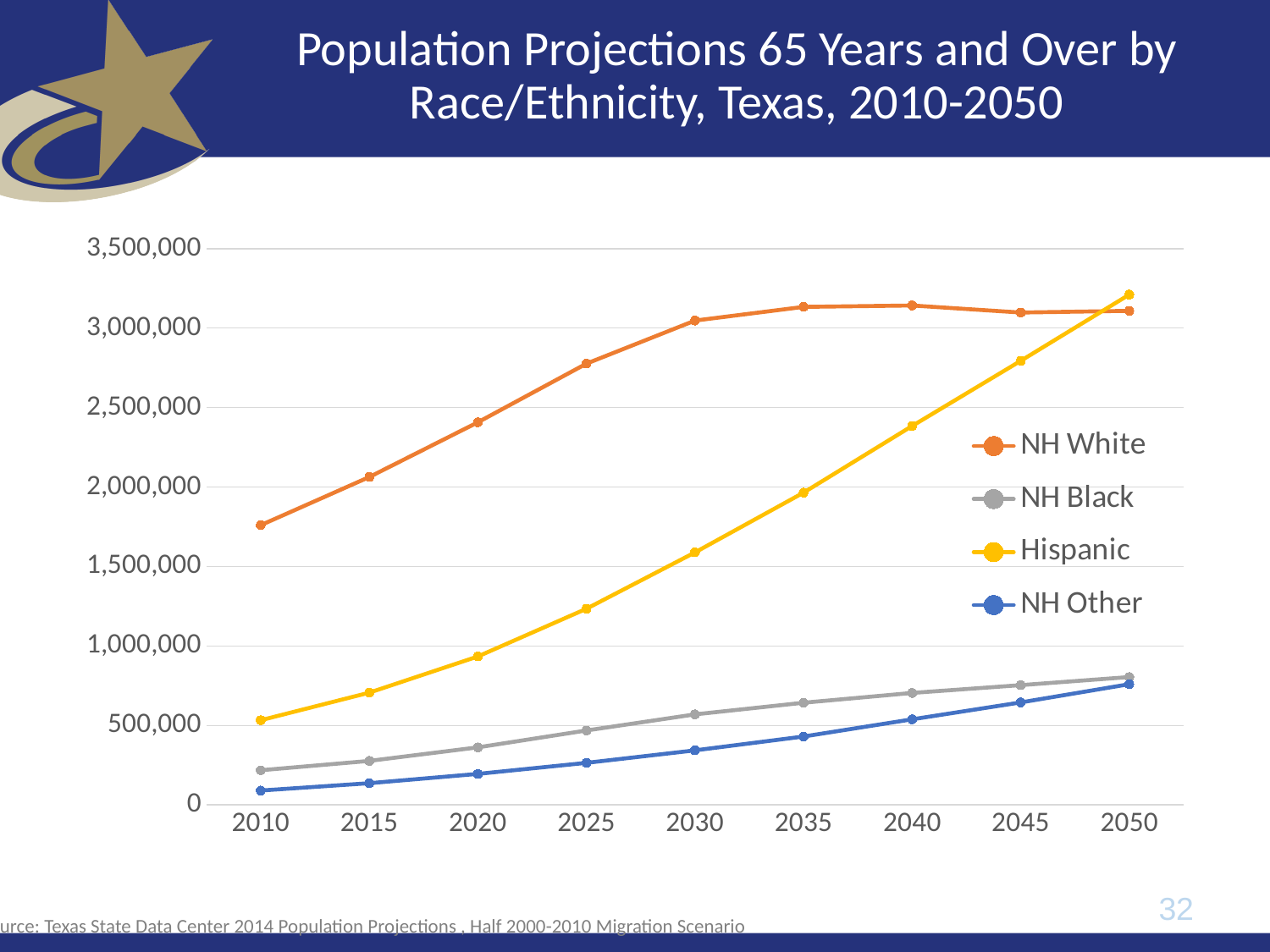
Is the Hispanic value for 2020 greater or less than 1,000,000? less Which series is drawn in yellow? Hispanic Is the NH Other value for 2010 greater or less than 500,000? less In 2050, which is larger: the Hispanic value or the NH White value? Hispanic How many series does the legend list? 4 Is the NH White value for 2010 greater or less than 1,500,000? greater Which race/ethnicity group has the lowest projected population 65 and over in 2010? NH Other How many years are plotted along the x axis? 9 What kind of chart is shown on the slide? line chart Does the Hispanic line rise or fall from 2010 to 2050? rise Which race/ethnicity group has the highest projected population 65 and over in 2010? NH White